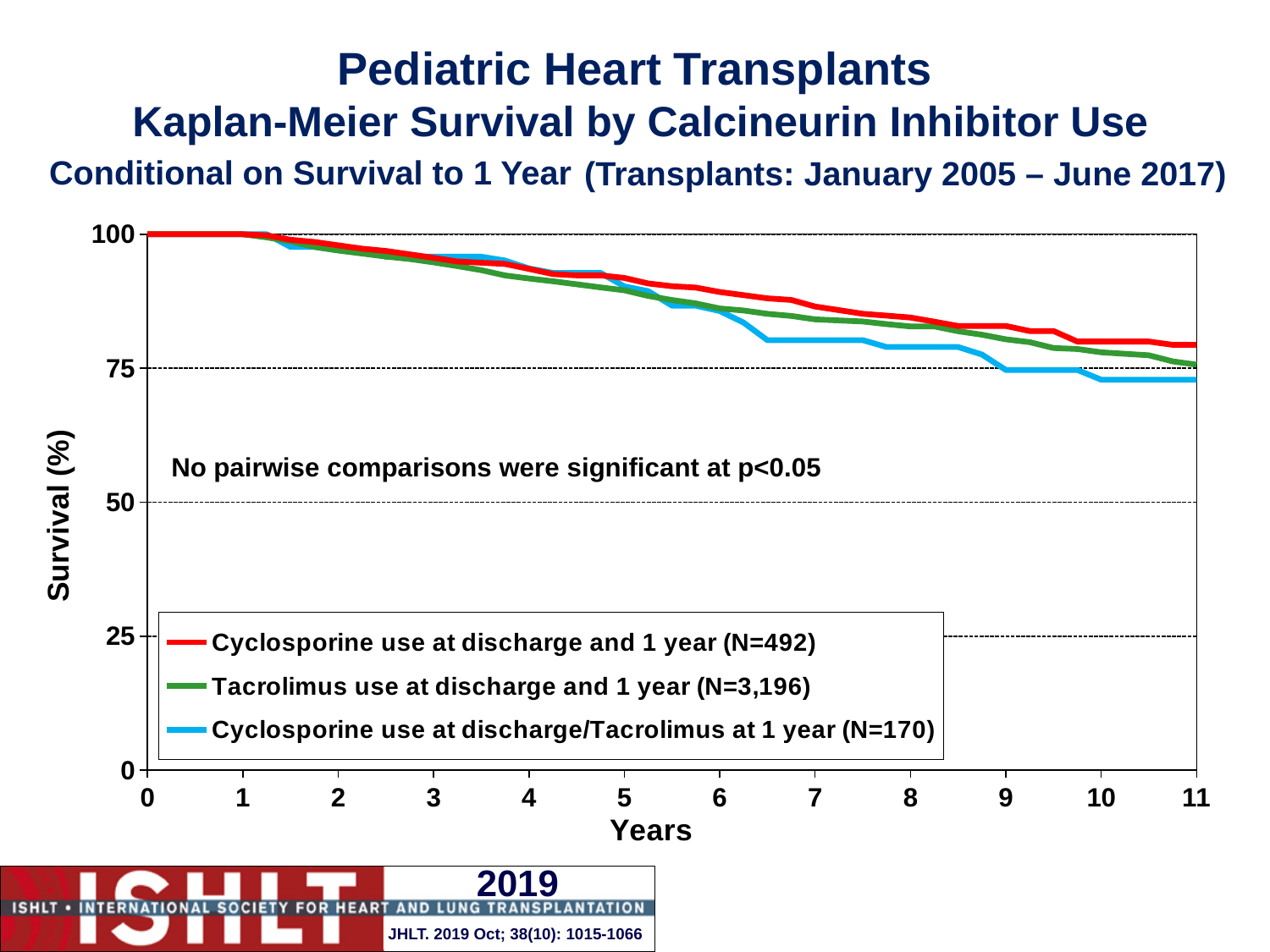
What is the N for the Tacrolimus use at discharge and 1 year series shown in the legend? N=3,196 What is the survival value for all three series at year 0? 100 Is the survival value for the Cyclosporine use at discharge/Tacrolimus at 1 year series at year 6 greater or less than 75? greater What is the label of the x axis? Years How many series does the legend list? 3 Which series has the lowest survival at year 11? Cyclosporine use at discharge/Tacrolimus at 1 year (N=170) Is the survival value for the Cyclosporine use at discharge and 1 year series at year 11 greater or less than 75? greater What kind of chart is shown on the slide? Line chart Which series has the highest survival at year 11? Cyclosporine use at discharge and 1 year (N=492) At year 7, which is higher: the Cyclosporine use at discharge and 1 year series or the Cyclosporine use at discharge/Tacrolimus at 1 year series? Cyclosporine use at discharge and 1 year Do the survival curves rise or fall as years increase? Fall